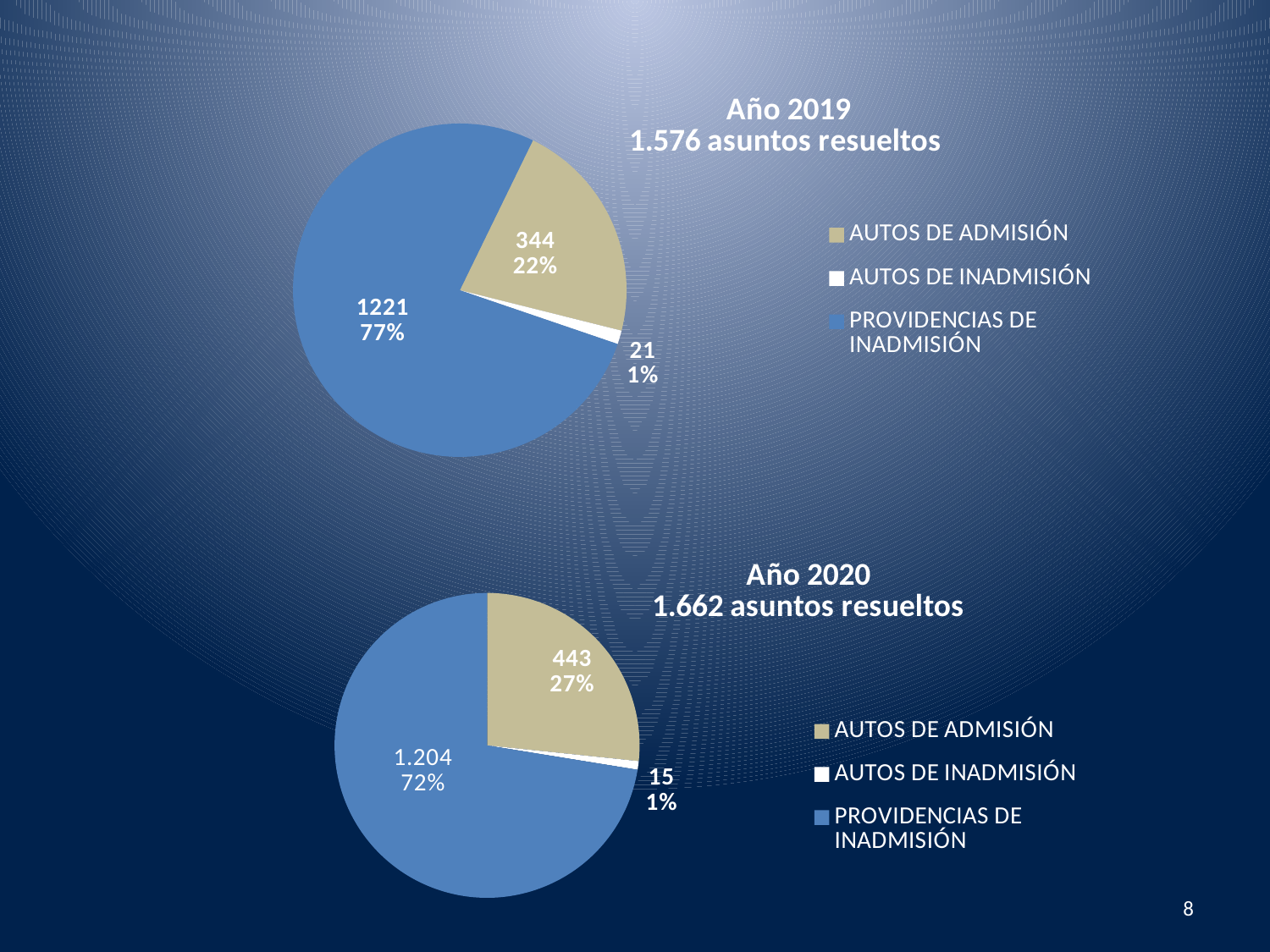
How many entries does the legend of the Año 2019 chart list? 3 In the Año 2019 chart, which category has the smallest slice? AUTOS DE INADMISIÓN In the Año 2019 chart, what is the value for AUTOS DE ADMISIÓN? 344 In the Año 2020 chart, which category has the largest slice? PROVIDENCIAS DE INADMISIÓN In the Año 2020 chart, what share of the pie is AUTOS DE ADMISIÓN? 27% What kind of chart is the Año 2019 chart? Pie chart What is the title of the bottom chart? Año 2020 1.662 asuntos resueltos Which is larger: AUTOS DE ADMISIÓN in the Año 2019 chart or AUTOS DE ADMISIÓN in the Año 2020 chart? Año 2020 In the Año 2019 chart, what is the difference between PROVIDENCIAS DE INADMISIÓN and AUTOS DE ADMISIÓN? 877 In the Año 2020 chart, what is the value for AUTOS DE INADMISIÓN? 15 How many slices does the Año 2020 chart have? 3 In the Año 2019 chart, what share of the pie is PROVIDENCIAS DE INADMISIÓN? 77%